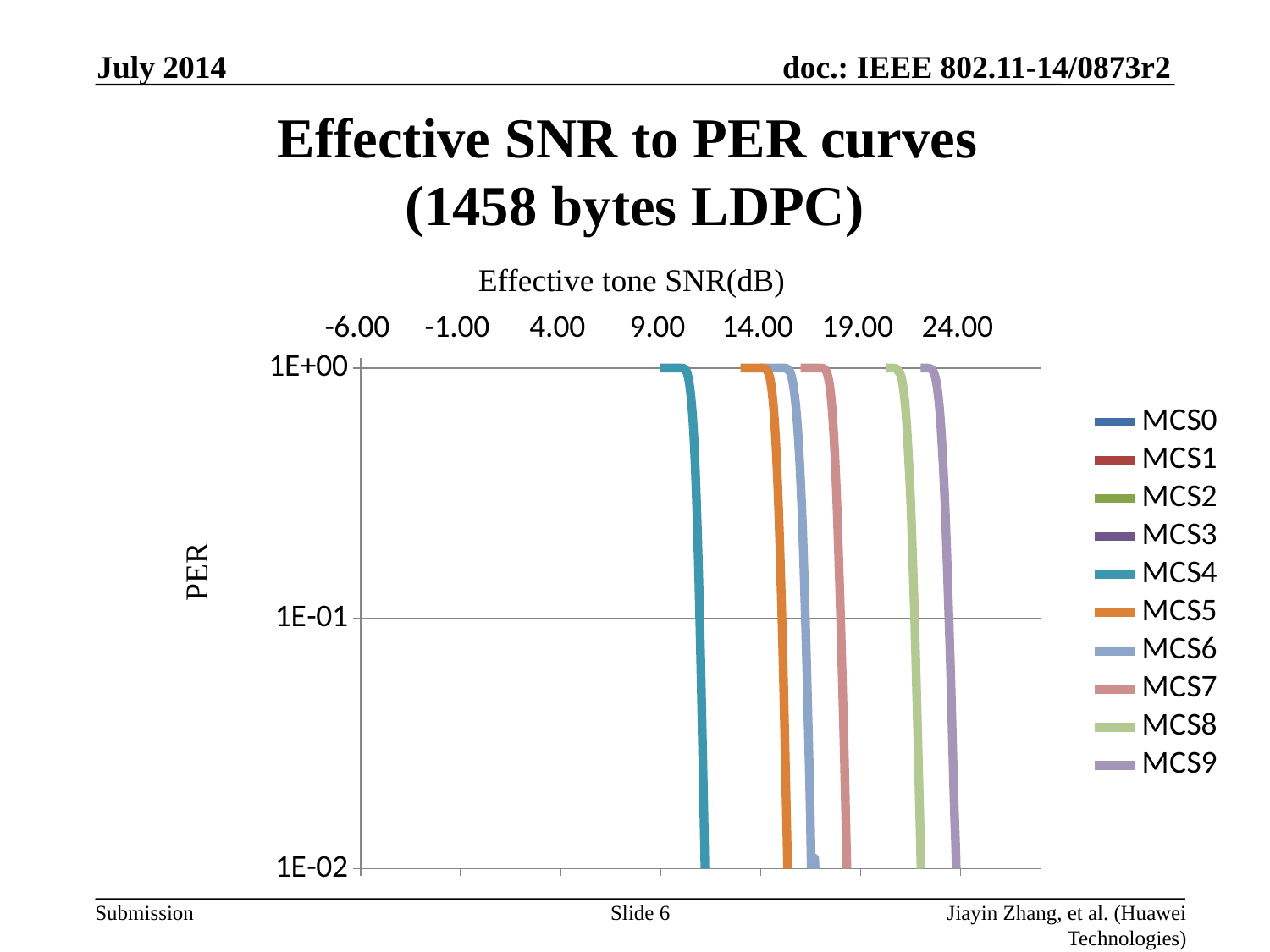
What is the title of the chart? Effective SNR to PER curves (1458 bytes LDPC) Is the SNR at which the MCS9 curve reaches a PER of 1E-01 greater or less than 19.00? greater Is the SNR at which the MCS7 curve reaches a PER of 1E-01 greater or less than 14.00? greater How many series does the legend list? 10 As the effective tone SNR increases along the x axis, does the PER for each series rise or fall? fall Which series' curve lies furthest to the right (highest SNR) on the chart? MCS9 Is the SNR at which the MCS4 curve reaches a PER of 1E-01 greater or less than 14.00? less Which series reaches a PER of 1E-01 at a higher SNR, MCS4 or MCS7? MCS7 Among the curves visible on the chart, which series lies furthest to the left (lowest SNR)? MCS4 Which series reaches a PER of 1E-01 at a higher SNR, MCS8 or MCS9? MCS9 What is the label of the horizontal axis? Effective tone SNR(dB) What kind of chart is shown on the slide? line chart